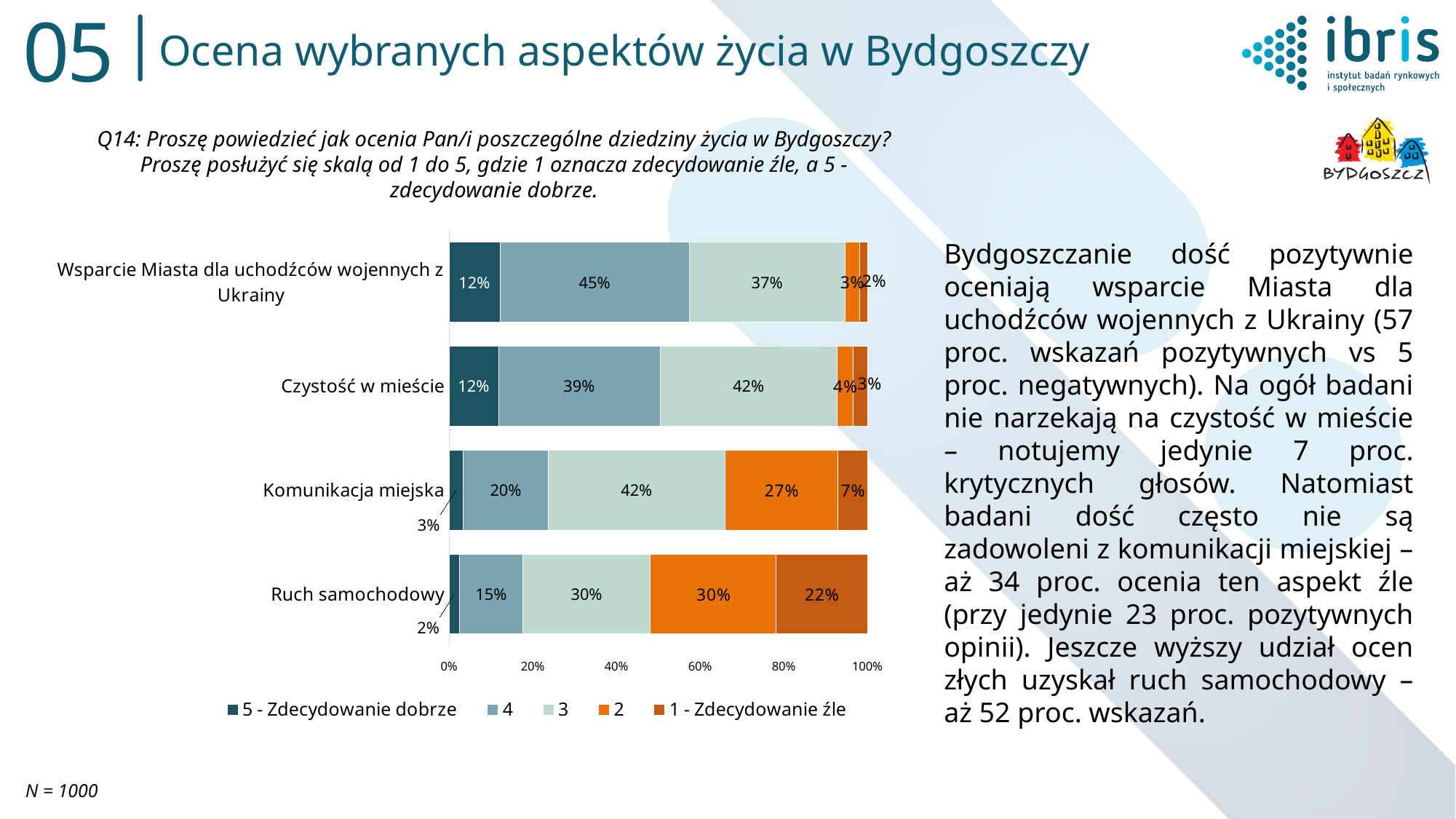
What is the value of the '3' series for 'Czystość w mieście'? 42% What kind of chart is shown on the slide? Stacked bar chart How many categories (aspects of life) are shown in the chart? 4 Which category has the lowest value for the '5 - Zdecydowanie dobrze' series? Ruch samochodowy Which category has the highest value for the '1 - Zdecydowanie źle' series? Ruch samochodowy How many series does the chart legend list? 5 What is the value of the '4' series for 'Wsparcie Miasta dla uchodźców wojennych z Ukrainy'? 45% What is the difference between the '4' series values for 'Wsparcie Miasta dla uchodźców wojennych z Ukrainy' and 'Czystość w mieście'? 6% What is the value of the '1 - Zdecydowanie źle' series for 'Ruch samochodowy'? 22% What is the value of the '2' series for 'Komunikacja miejska'? 27% Which is larger: the '2' series value for 'Komunikacja miejska' or for 'Ruch samochodowy'? Ruch samochodowy Which legend entry is shown in the darkest orange colour? 1 - Zdecydowanie źle